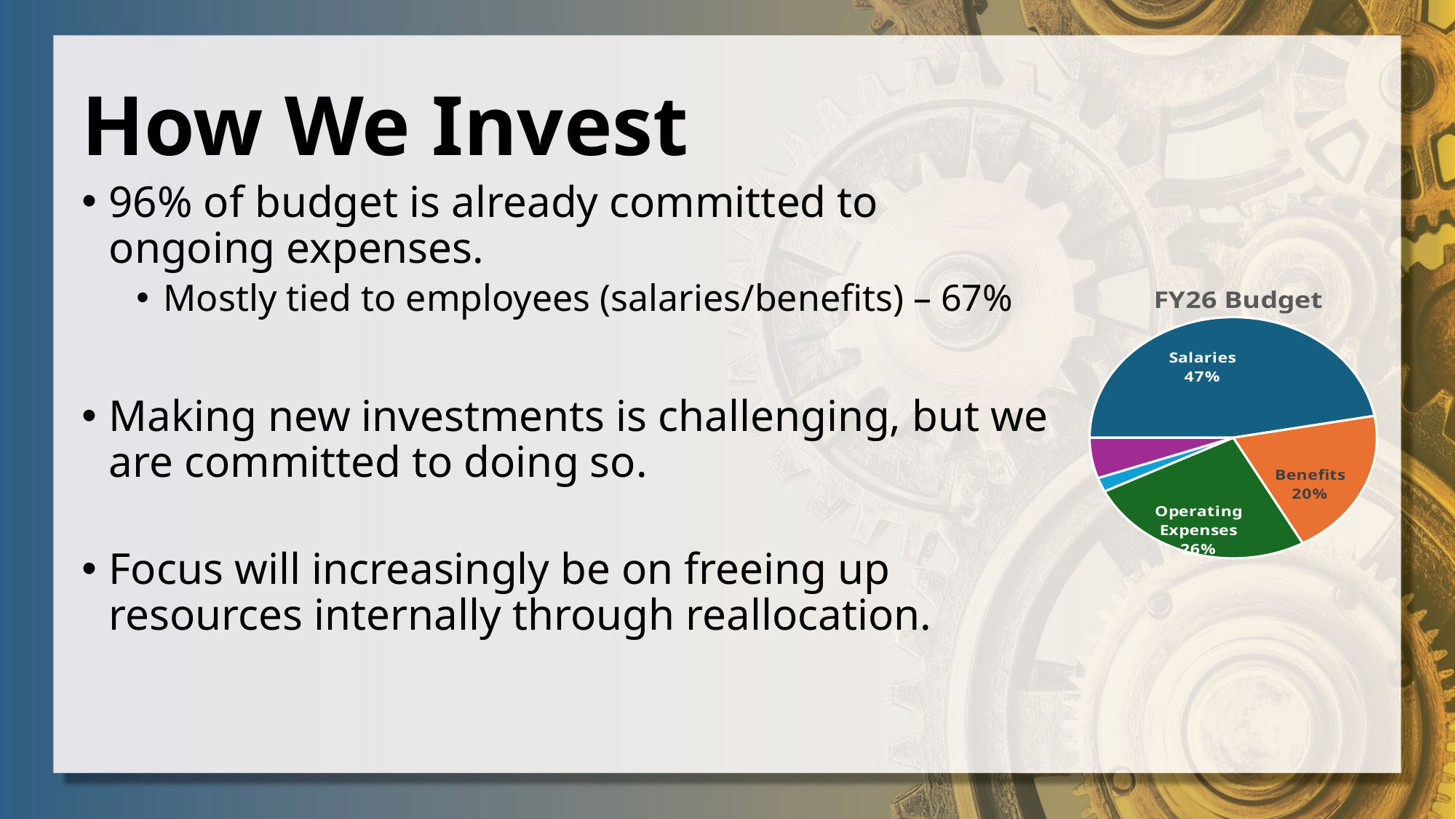
What colour is the Benefits slice in the pie chart? orange How many slices does the FY26 Budget pie chart have? 5 What is the title of the chart? FY26 Budget What percentage of the FY26 Budget is Operating Expenses? 26% Which category has the largest slice of the FY26 Budget pie? Salaries What share of the FY26 Budget pie does the Salaries slice represent? 47% What kind of chart is shown on the slide? pie chart What percentage of the FY26 Budget is Benefits? 20% How many percentage points larger is the Salaries slice than the Benefits slice? 27% What percentage of the FY26 Budget is Salaries? 47% Which slice is larger, Salaries or Benefits? Salaries Which slice is larger, Benefits or Operating Expenses? Operating Expenses